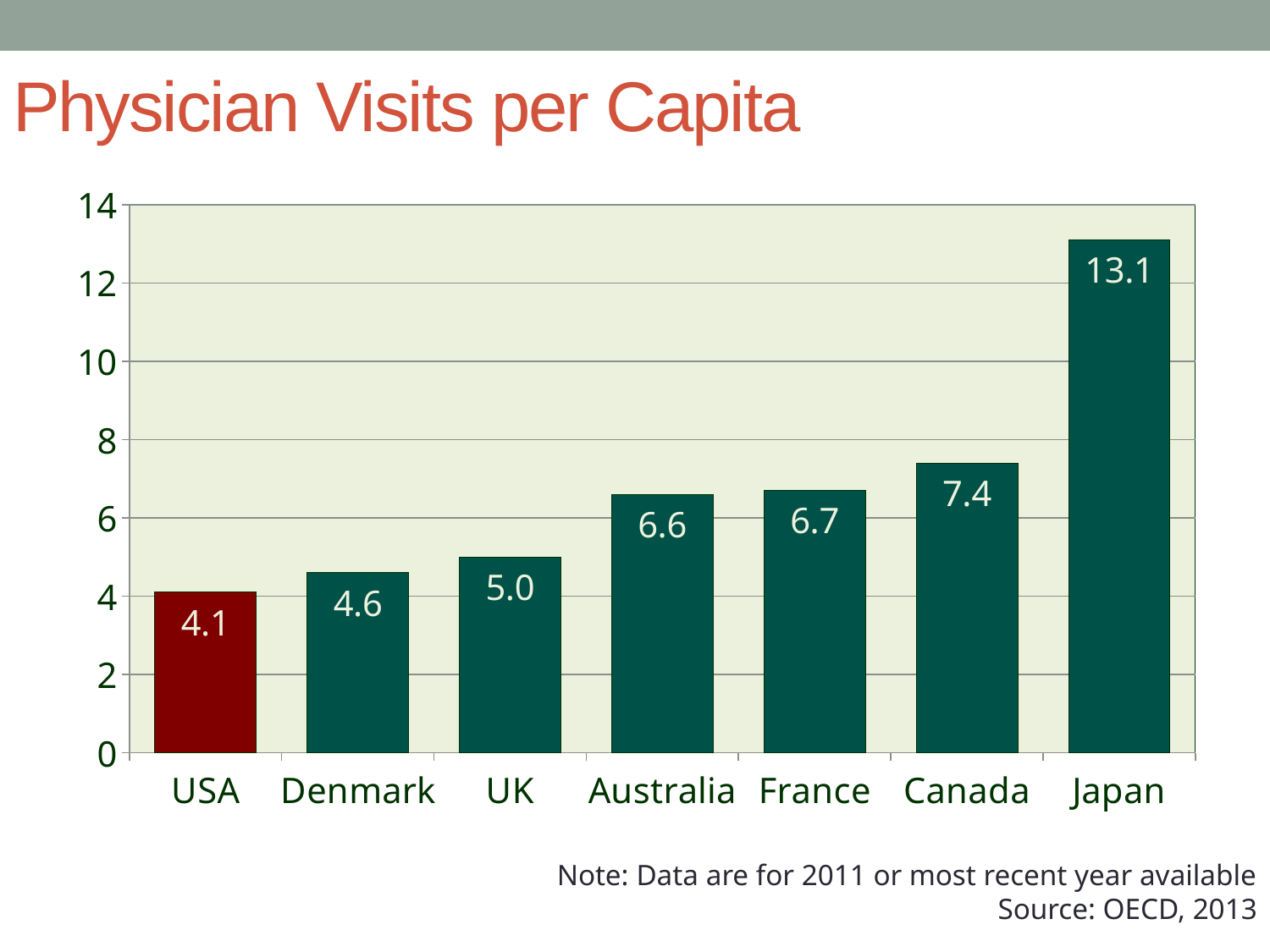
How many countries are shown on the chart? 7 Which is larger, the value for Australia or the value for UK? Australia Which country has the lowest number of physician visits per capita? USA What is the value for Canada? 7.4 Is the value for Canada greater or less than 8? less What is the value for Japan? 13.1 What kind of chart is shown on the slide? bar chart What is the value for the USA? 4.1 Which bar is coloured differently from the others? USA What is the difference between the values for Canada and Denmark? 2.8 Which country has the highest number of physician visits per capita? Japan What is the difference between the values for Japan and the USA? 9.0